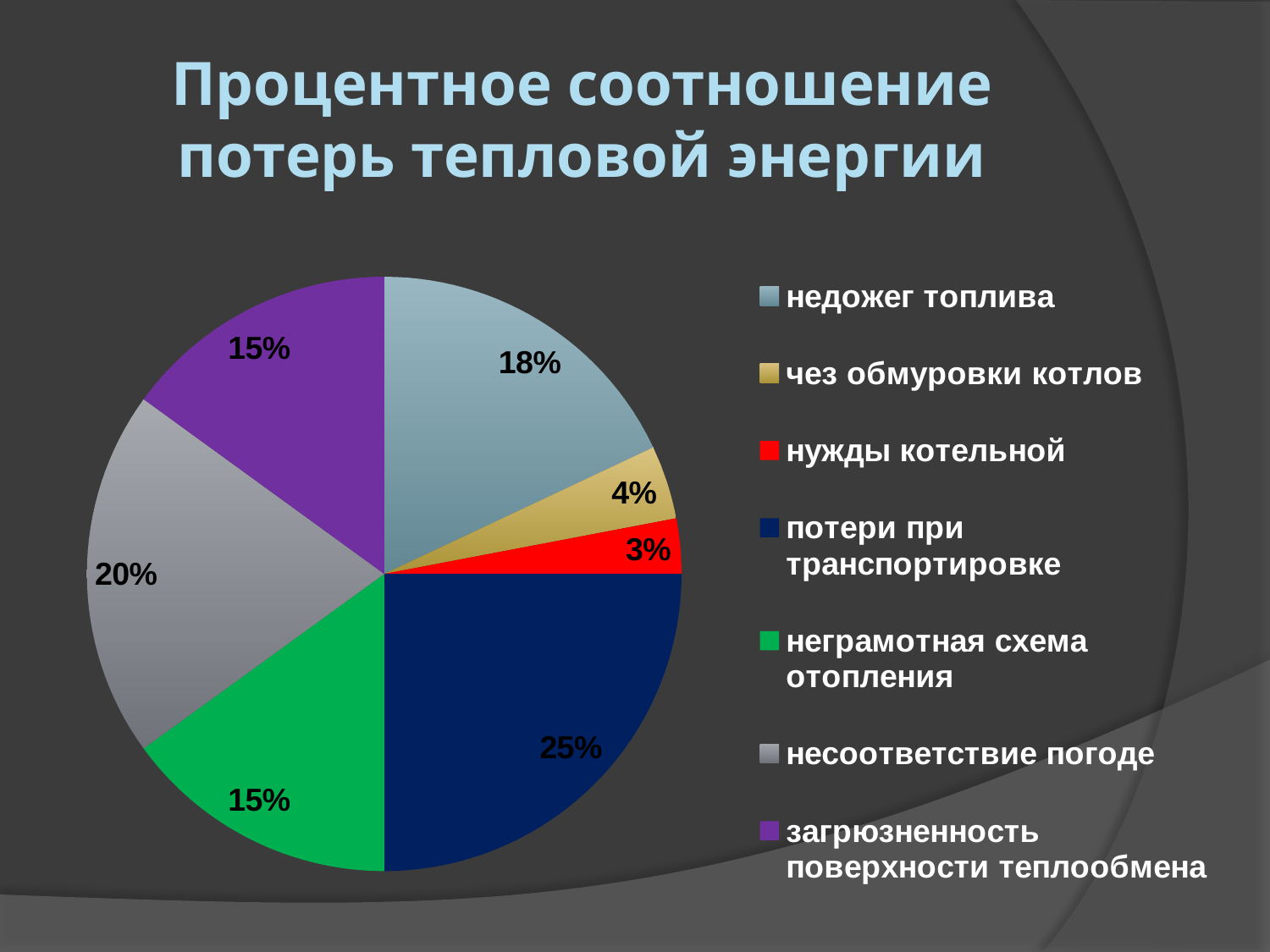
Which category has the largest slice of the pie? потери при транспортировке What percentage is shown for "потери при транспортировке"? 25% What percentage is shown for "нужды котельной"? 3% What kind of chart is shown on the slide? Pie chart How many categories does the legend of the pie chart list? 7 Which is larger: the share for "несоответствие погоде" or the share for "неграмотная схема отопления"? несоответствие погоде What share of the pie is labelled for "недожег топлива"? 18% What colour is the slice for "загрюзненность поверхности теплообмена"? Purple What is the title of the chart on the slide? Процентное соотношение потерь тепловой энергии Which category has the smallest slice of the pie? нужды котельной What is the difference between the shares of "потери при транспортировке" and "недожег топлива"? 7% What percentage is shown for "несоответствие погоде"? 20%